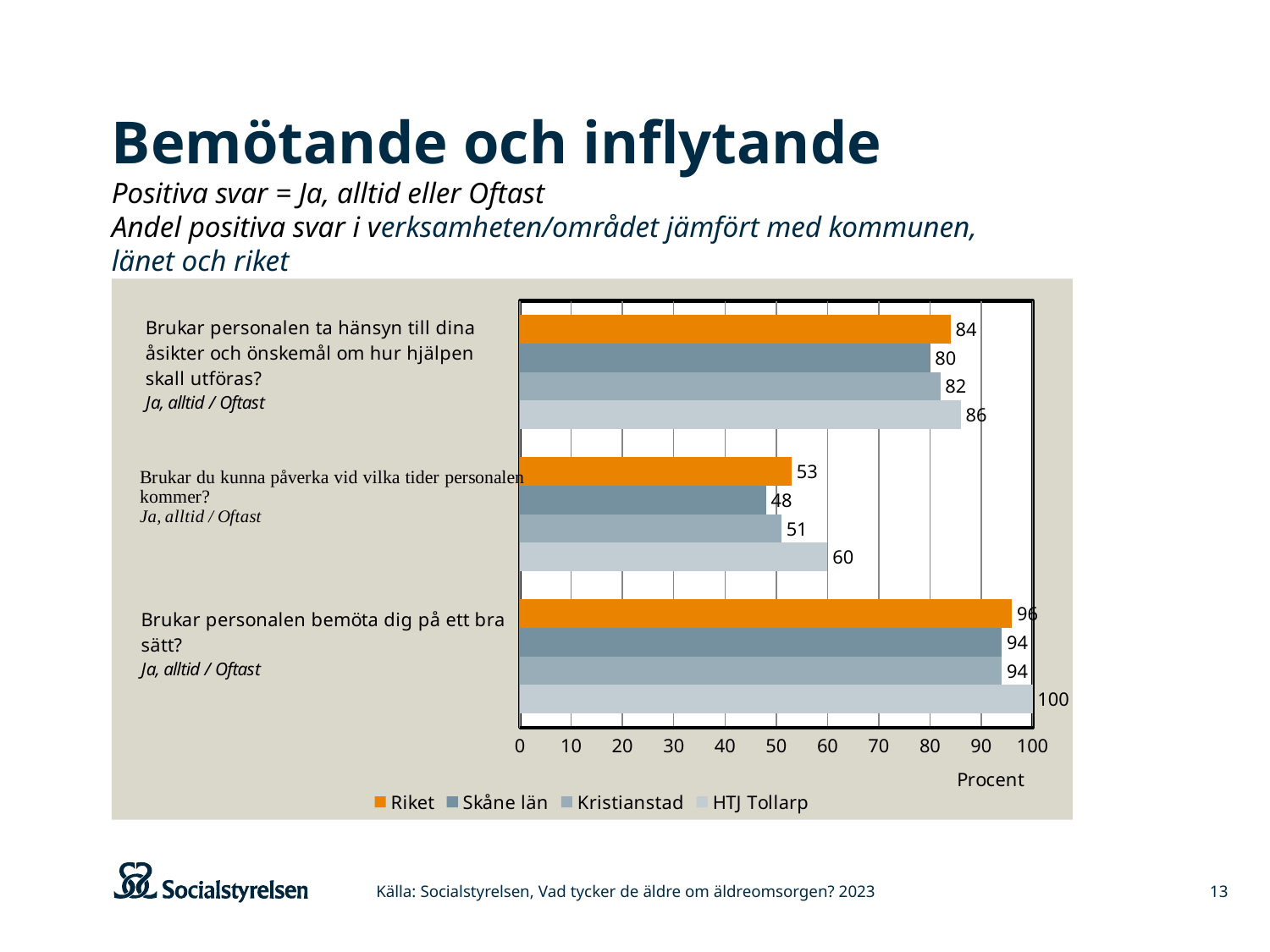
What is the value for Skåne län on the question "Brukar personalen bemöta dig på ett bra sätt?"? 94 Is the value for Kristianstad on the question "Brukar du kunna påverka vid vilka tider personalen kommer?" greater or less than 60? less What is the value for HTJ Tollarp on the question "Brukar du kunna påverka vid vilka tider personalen kommer?"? 60 What kind of chart is shown on the slide? bar chart How many series does the legend list? 4 Which series has the highest value on the question "Brukar personalen bemöta dig på ett bra sätt?"? HTJ Tollarp What is the value for Riket on the question "Brukar personalen ta hänsyn till dina åsikter och önskemål om hur hjälpen skall utföras?"? 84 How many questions (categories) are plotted in the chart? 3 What is the label of the x axis? Procent Which is larger on the question "Brukar personalen ta hänsyn till dina åsikter och önskemål om hur hjälpen skall utföras?": Kristianstad or Skåne län? Kristianstad Which series has the lowest value on the question "Brukar du kunna påverka vid vilka tider personalen kommer?"? Skåne län What is the difference between HTJ Tollarp and Riket on the question "Brukar du kunna påverka vid vilka tider personalen kommer?"? 7